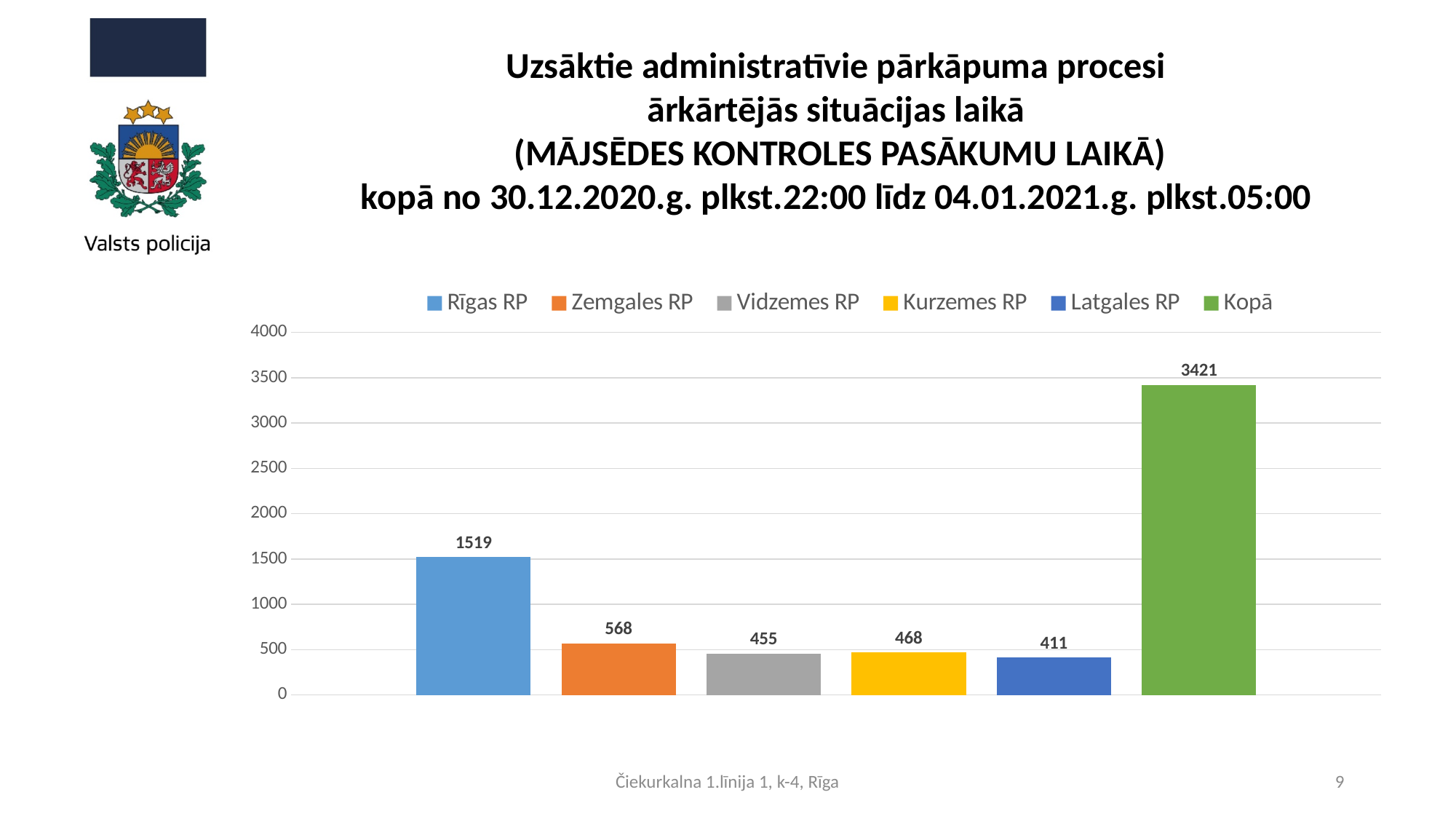
How many series does the legend list? 6 What kind of chart is shown on the slide? Bar chart Which bar has the lowest value? Latgales RP What is the difference between the values for Rīgas RP and Zemgales RP? 951 Which is larger, the value for Zemgales RP or the value for Kurzemes RP? Zemgales RP What is the difference between the values for Kurzemes RP and Vidzemes RP? 13 What is the value for Rīgas RP? 1519 Is the value for Rīgas RP greater or less than 1500? greater What is the value shown for Kopā? 3421 What is the value for Latgales RP? 411 What is the value for Zemgales RP? 568 Which regional police (RP) has the highest value? Rīgas RP